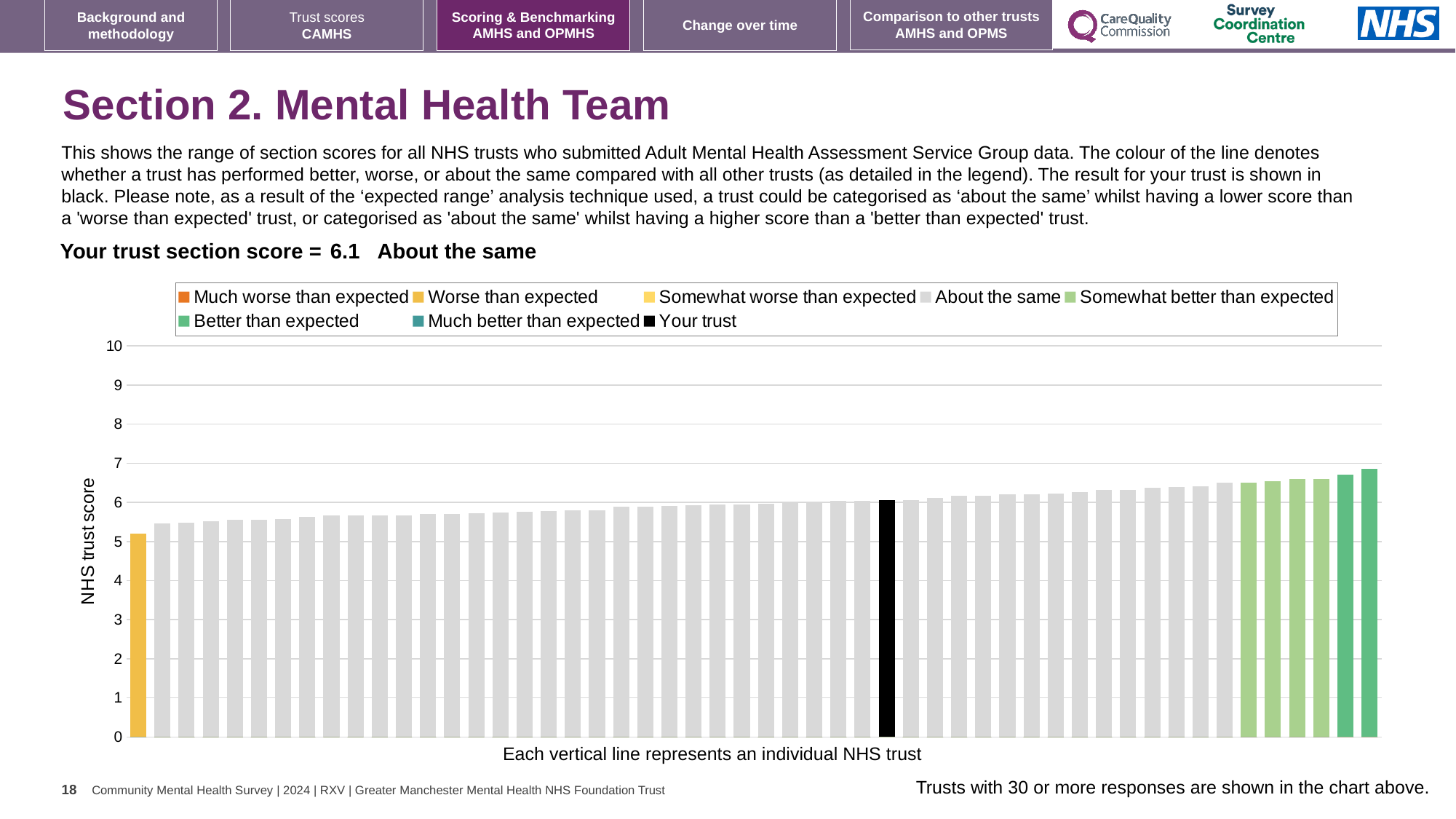
What kind of chart is shown on the slide? bar chart Which performance category is 'Your trust' placed in according to the slide? About the same How many bars are coloured as 'Much better than expected'? 0 How many entries does the chart legend list? 8 How many bars are coloured as 'Somewhat better than expected'? 4 What is the label on the vertical axis of the chart? NHS trust score What is the section score for 'Your trust' shown on the slide? 6.1 Is the value of the 'Worse than expected' bar greater or less than 6? less Is the black 'Your trust' bar higher or lower than the rightmost bar in the chart? lower Which legend category does the lowest bar in the chart belong to? Worse than expected Do the bar values rise or fall from left to right along the x axis? rise Which legend category does the highest bar in the chart belong to? Better than expected